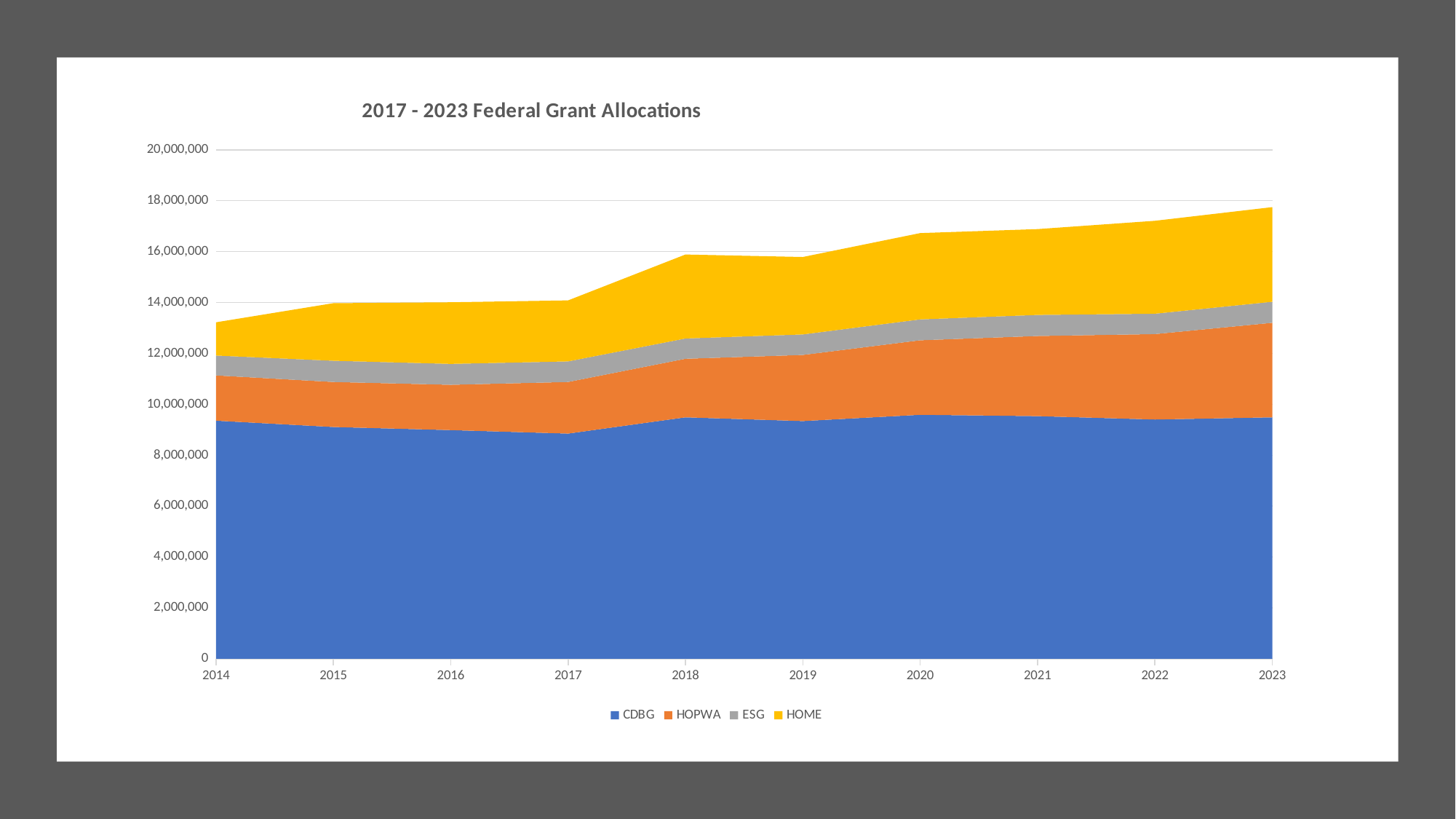
Is the total stacked value for 2023 greater or less than 16,000,000? greater Which year has the highest total allocation? 2023 What is the title of the chart? 2017 - 2023 Federal Grant Allocations How many series does the legend list? 4 How many years are shown along the x axis? 10 Is the total stacked value for 2014 greater or less than 14,000,000? less Which series is shown in yellow? HOME Is the CDBG value for 2014 greater or less than 10,000,000? less Does the total allocation rise or fall from 2014 to 2023? Rise What kind of chart is shown on the slide? Stacked area chart Which year has the lowest total allocation? 2014